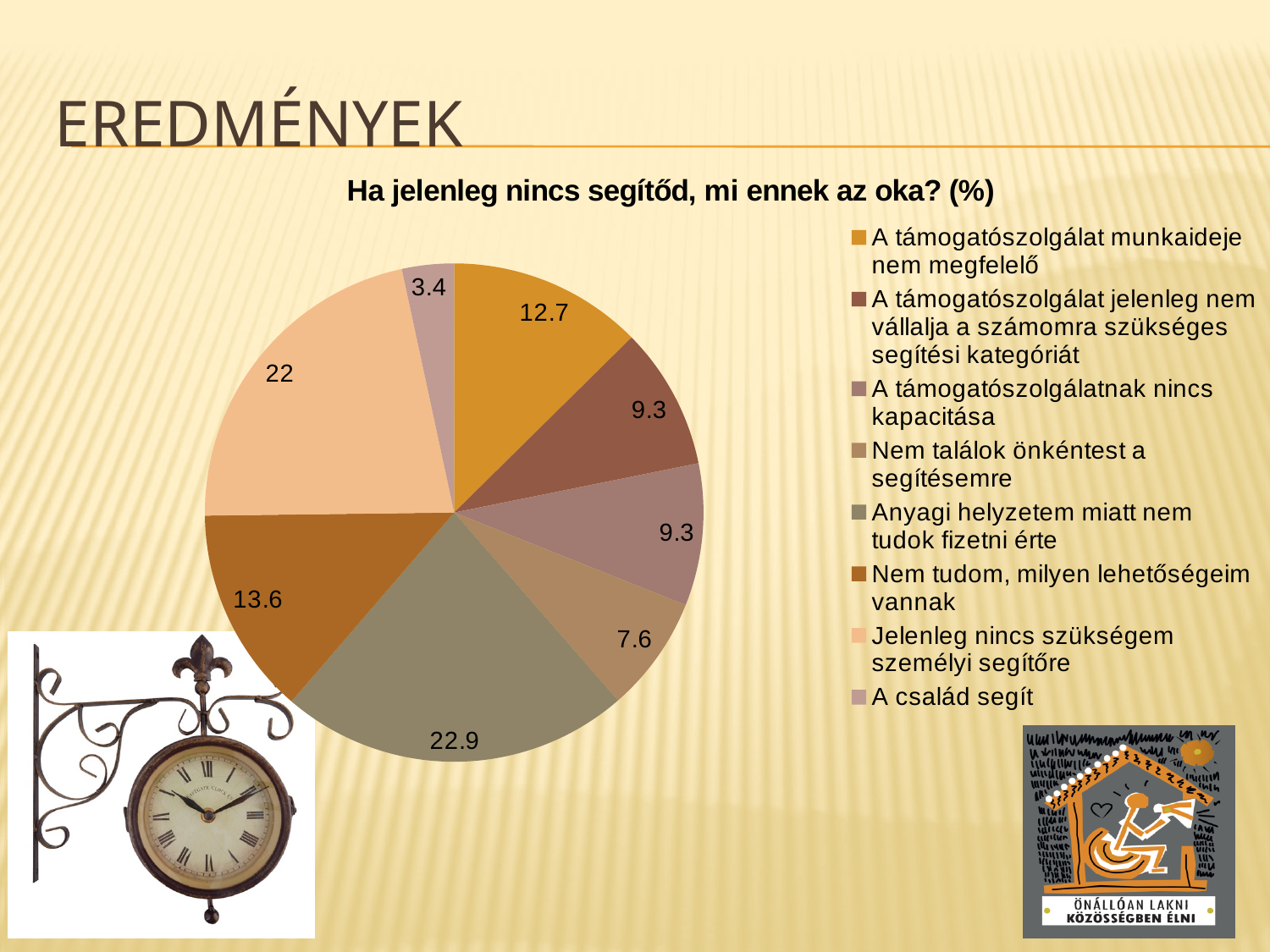
What is the value for "Jelenleg nincs szükségem személyi segítőre"? 22 Which category has the largest slice? Anyagi helyzetem miatt nem tudok fizetni érte What is the difference between the values for "Anyagi helyzetem miatt nem tudok fizetni érte" and "Jelenleg nincs szükségem személyi segítőre"? 0.9 What is the value for "A támogatószolgálat munkaideje nem megfelelő"? 12.7 What is the value for "Nem tudom, milyen lehetőségeim vannak"? 13.6 How many categories does the legend list? 8 What type of chart is shown on the slide? pie chart What is the title of the chart? Ha jelenleg nincs segítőd, mi ennek az oka? (%) What is the value for "Anyagi helyzetem miatt nem tudok fizetni érte"? 22.9 Which category has the smallest slice? A család segít Which is larger, the value for "Nem tudom, milyen lehetőségeim vannak" or the value for "Nem találok önkéntest a segítésemre"? Nem tudom, milyen lehetőségeim vannak What is the value for "A család segít"? 3.4